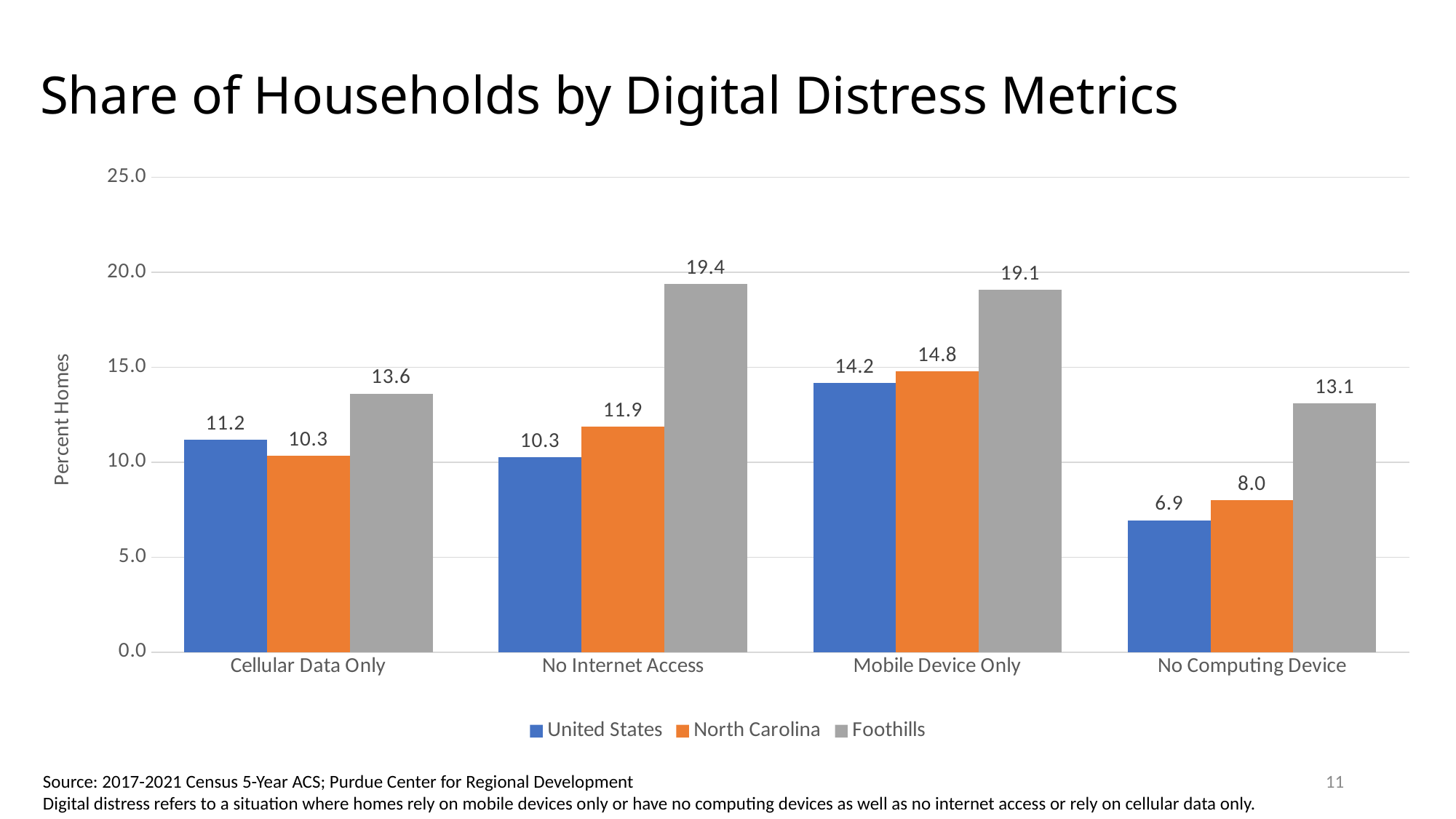
What is the label of the y axis? Percent Homes What is the value for Foothills in the No Internet Access category? 19.4 Which category has the highest Foothills value? No Internet Access Is the Foothills value for Mobile Device Only greater or less than 15.0? greater How many categories are shown on the x axis? 4 Which is larger in the Cellular Data Only category: United States or North Carolina? United States What kind of chart is shown on the slide? Bar chart What is the value for United States in the No Computing Device category? 6.9 What is the value for North Carolina in the Mobile Device Only category? 14.8 How many series does the legend list? 3 What is the difference between the Foothills and United States values for No Internet Access? 9.1 Which category has the lowest United States value? No Computing Device